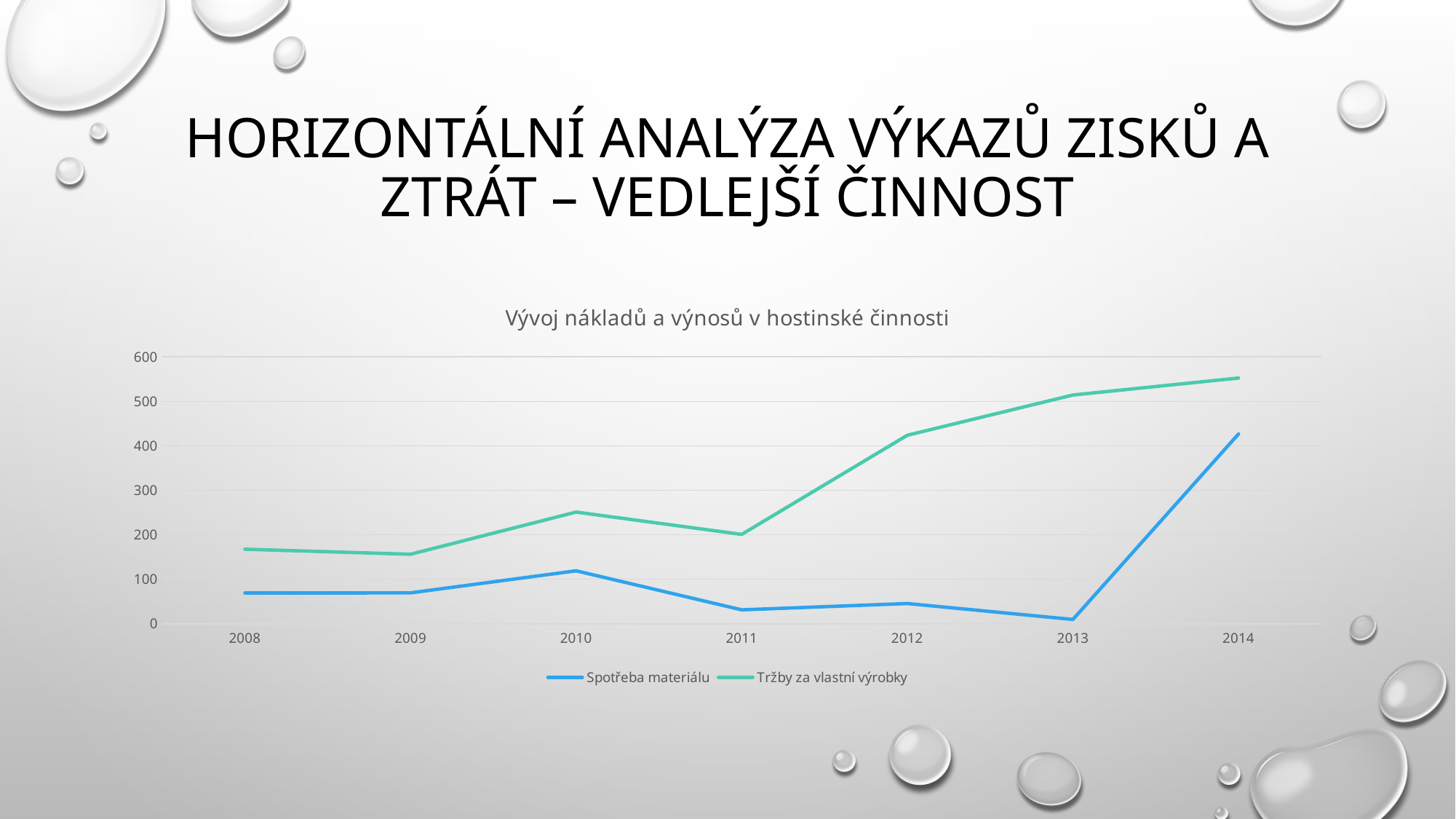
In which year is Tržby za vlastní výrobky highest? 2014 In which year is Spotřeba materiálu lowest? 2013 Which is larger in 2012, Spotřeba materiálu or Tržby za vlastní výrobky? Tržby za vlastní výrobky Is the value for Tržby za vlastní výrobky in 2013 greater or less than 500? greater How many series does the legend list? 2 What is the title of the chart? Vývoj nákladů a výnosů v hostinské činnosti What kind of chart is shown on the slide? line chart Is the value for Spotřeba materiálu in 2010 greater or less than 100? greater How many years are plotted along the x axis? 7 Which series is drawn in green? Tržby za vlastní výrobky Does Tržby za vlastní výrobky rise or fall from 2011 to 2014? rise In which year is Spotřeba materiálu highest? 2014